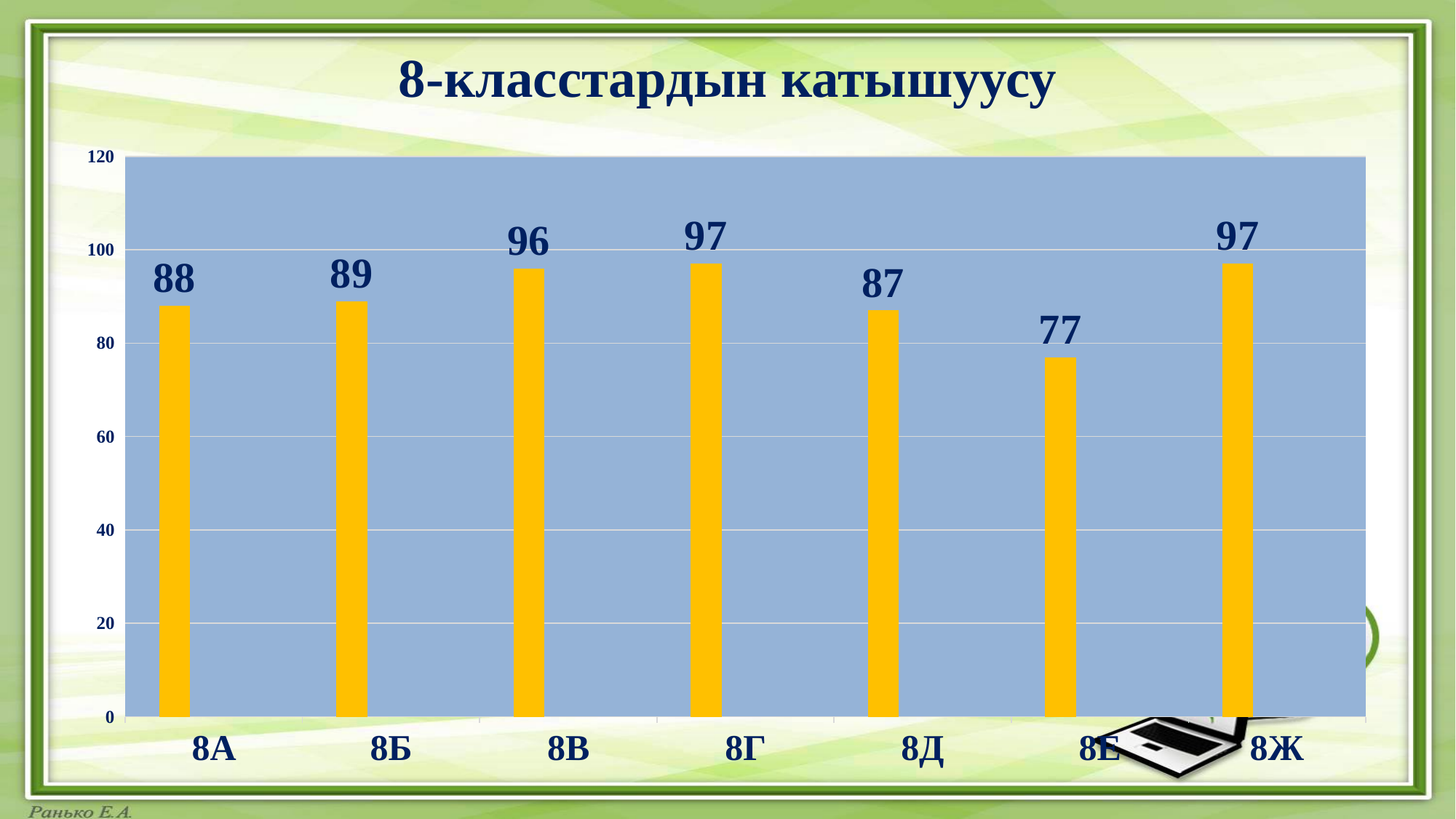
What is the difference between the values for 8Г and 8Е? 20 What is the value for 8Е? 77 What is the difference between the values for 8В and 8А? 8 What is the title of the chart? 8-класстардын катышуусу What is the value for 8А? 88 Is the value for 8Е greater or less than 80? less Which category has the lowest value? 8Е What is the value for 8Д? 87 What is the value for 8В? 96 How many categories are shown on the x axis? 7 Which is larger, the value for 8Б or the value for 8Е? 8Б What kind of chart is shown on the slide? bar chart